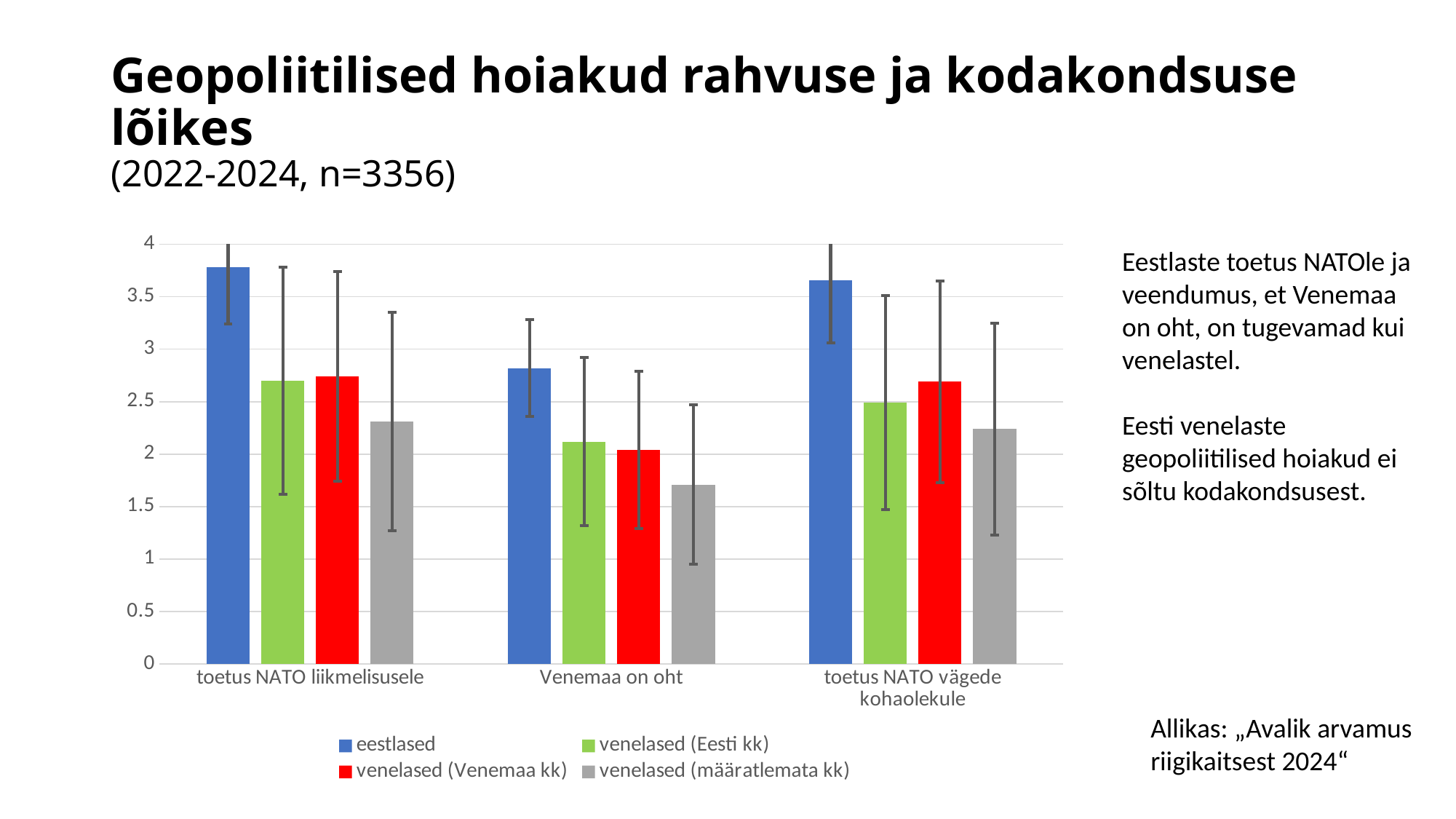
In which category is the eestlased bar the lowest? Venemaa on oht In "toetus NATO vägede kohaolekule", which is larger: venelased (Eesti kk) or venelased (määratlemata kk)? venelased (Eesti kk) Which series is shown in red in the legend? venelased (Venemaa kk) How many series does the legend list? 4 How many categories are shown on the x axis? 3 Is the value for venelased (määratlemata kk) in "Venemaa on oht" greater or less than 2? less Which series has the lowest bar in the category "Venemaa on oht"? venelased (määratlemata kk) Is the value for eestlased in "Venemaa on oht" greater or less than 3? less For the eestlased series, which is larger: "toetus NATO liikmelisusele" or "Venemaa on oht"? toetus NATO liikmelisusele Is the value for eestlased in "toetus NATO liikmelisusele" greater or less than 3.5? greater What kind of chart is shown on the slide? bar chart Which series has the highest bar in the category "toetus NATO liikmelisusele"? eestlased